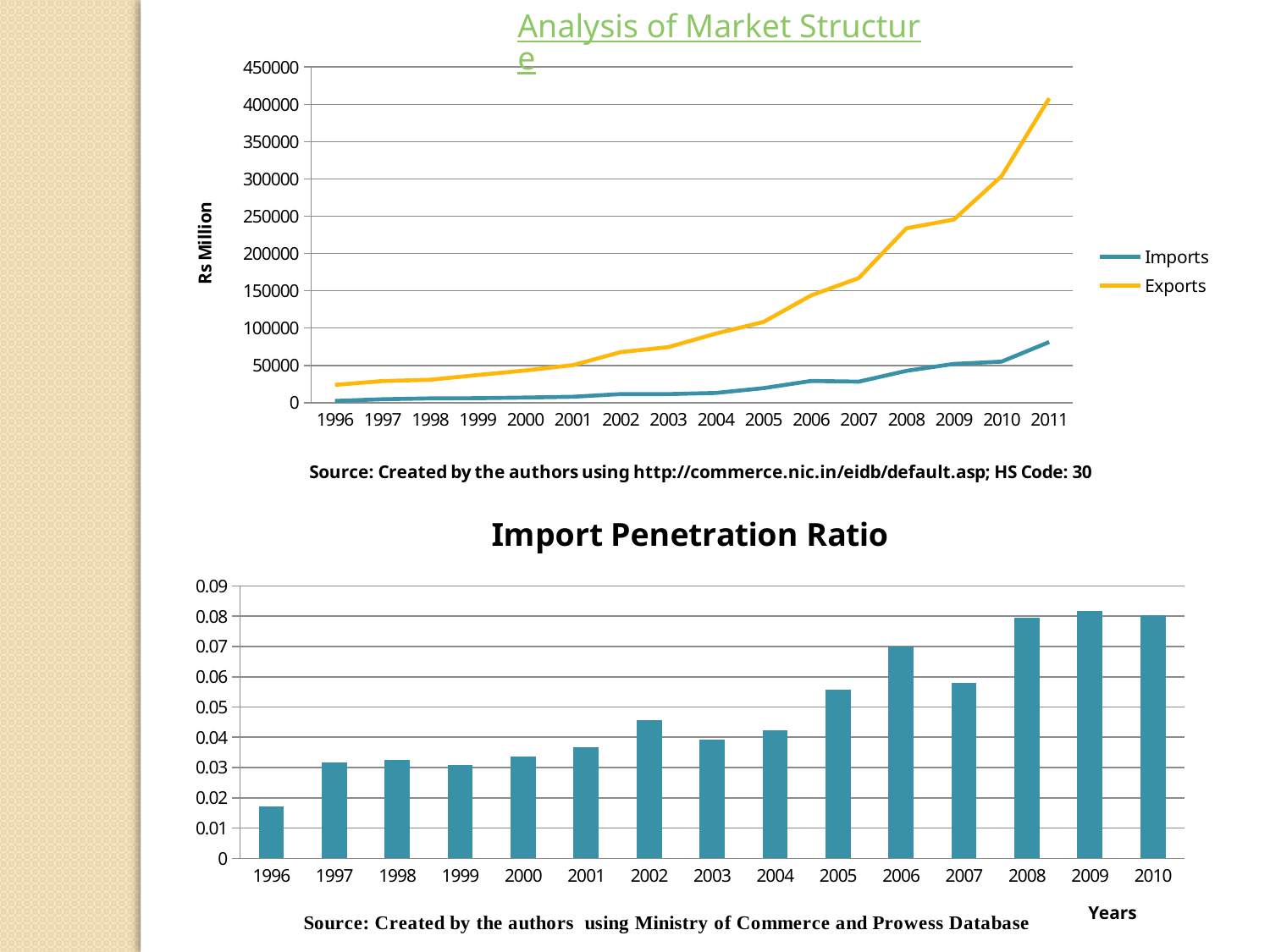
In the Import Penetration Ratio chart, which year has the lowest value? 1996 In the Import Penetration Ratio chart, how many years are plotted? 15 In the top chart (Analysis of Market Structure), which series is higher in 2011, Imports or Exports? Exports In the top chart (Analysis of Market Structure), what kind of chart is it? line chart In the top chart (Analysis of Market Structure), is the Imports value for 2011 greater or less than 100000? less In the Import Penetration Ratio chart, which year has the larger value, 2006 or 2007? 2006 In the top chart (Analysis of Market Structure), how many series does the legend list? 2 In the Import Penetration Ratio chart, what kind of chart is it? bar chart In the top chart (Analysis of Market Structure), what is the label on the vertical axis? Rs Million In the top chart (Analysis of Market Structure), is the Exports value for 2011 greater or less than 350000? greater In the Import Penetration Ratio chart, is the value for 2005 greater or less than 0.05? greater